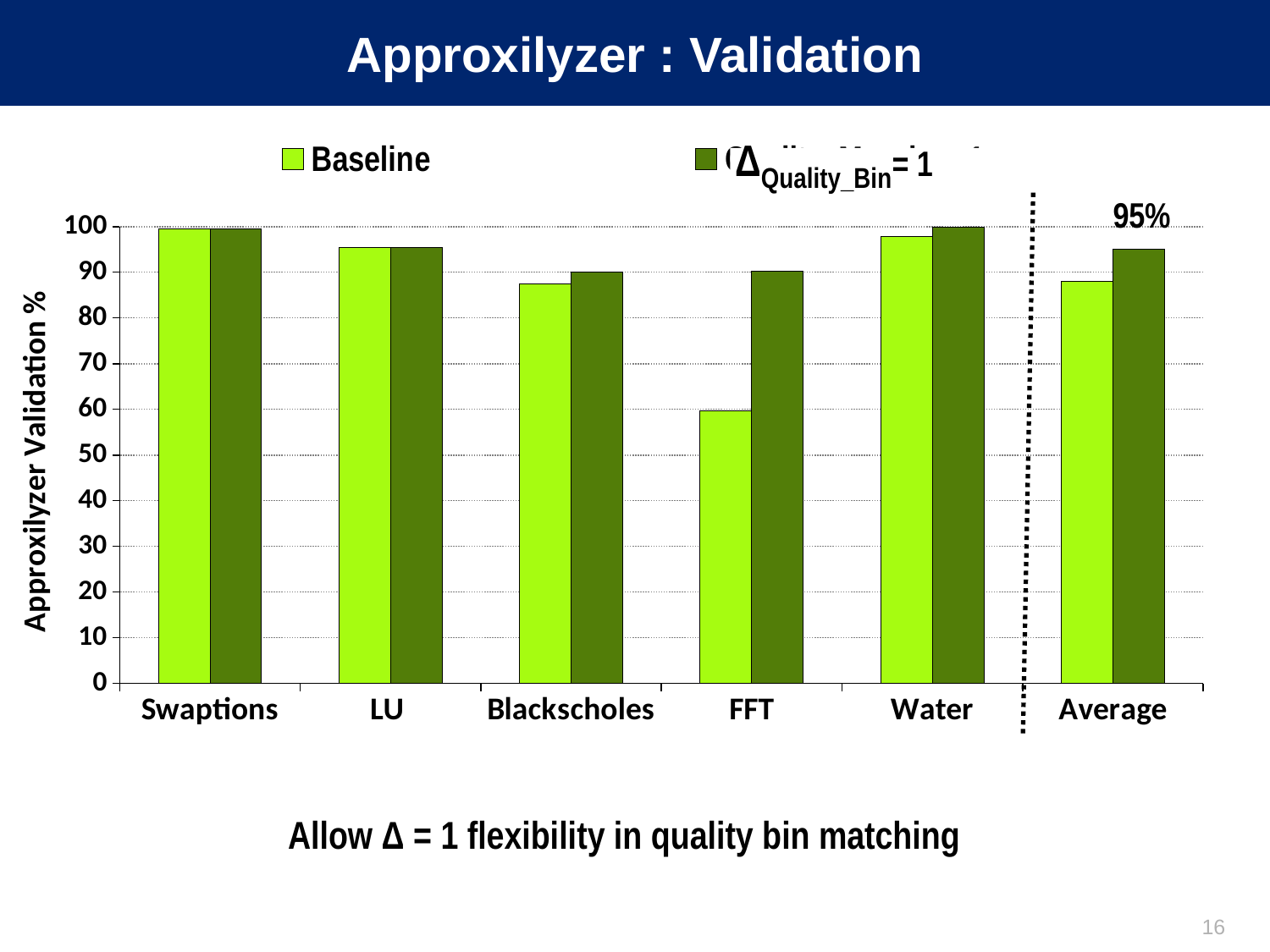
Which has the larger Baseline value: Swaptions or FFT? Swaptions Is the Baseline value for Water greater or less than 90? greater How many series does the chart's legend list? 2 Which category has the lowest Baseline value? FFT What is the ΔQuality_Bin = 1 value for Average? 95% Is the Baseline value for Blackscholes greater or less than 80? greater What is the title of the chart's y axis? Approxilyzer Validation % What kind of chart is shown on the slide? bar chart Is the Baseline value for FFT greater or less than 70? less What is the first entry in the chart's legend? Baseline For FFT, which is larger: the Baseline value or the ΔQuality_Bin = 1 value? ΔQuality_Bin = 1 How many categories are shown on the x axis of the chart? 6